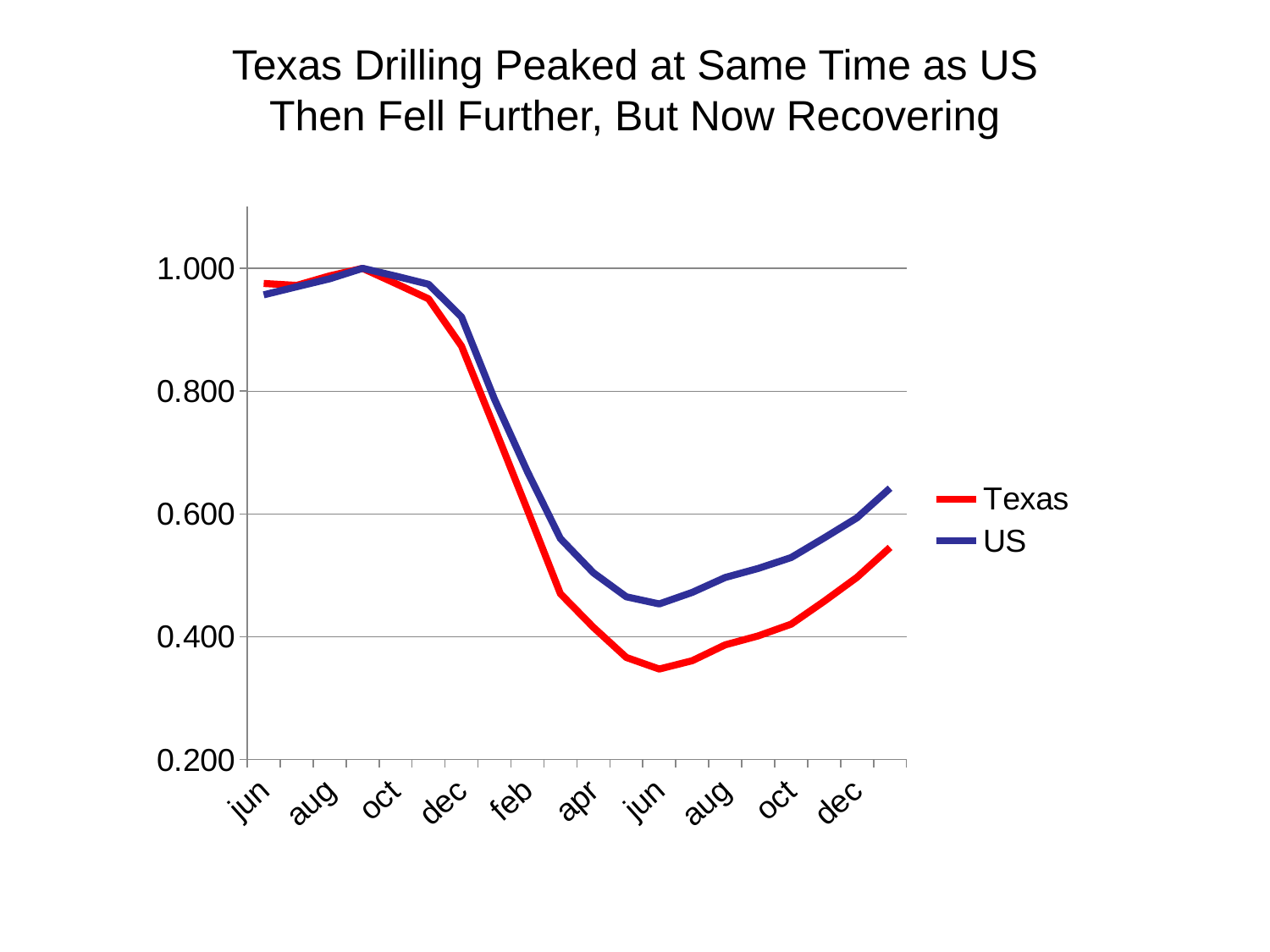
How many series does the legend list? 2 At apr, is the value for US greater or less than 0.600? less Do the lines rise or fall between the first oct and the second jun? fall At which month does the Texas line reach its lowest value? jun (the second jun) How many month labels are shown on the x axis? 10 At the second jun, is the value for US greater or less than 0.400? greater Which series is drawn in red? Texas What kind of chart is shown on the slide? line chart At the second jun, is the value for Texas greater or less than 0.400? less At the second jun, which series has the higher value, Texas or US? US What is the title of the chart? Texas Drilling Peaked at Same Time as US Then Fell Further, But Now Recovering